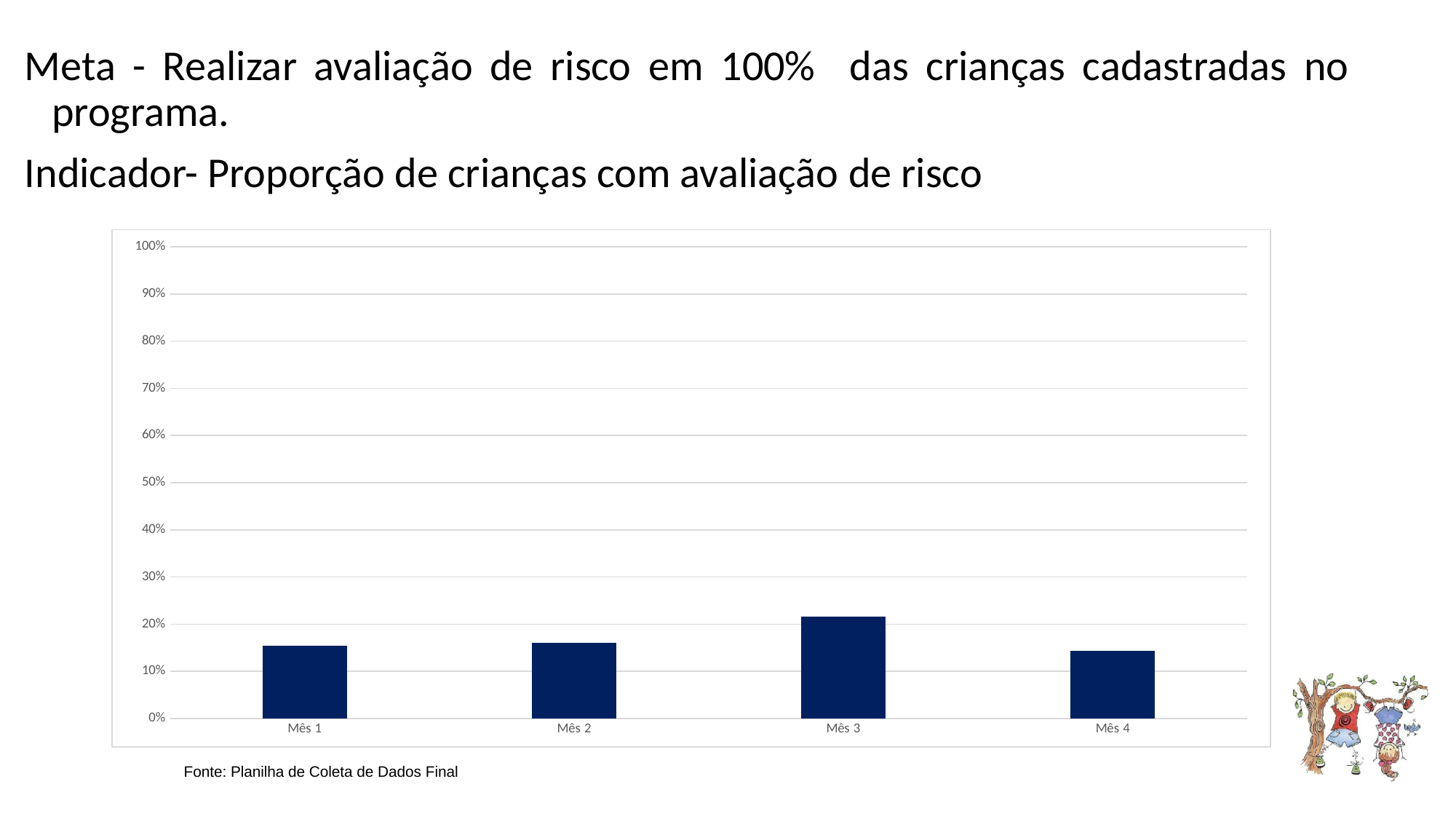
What source is cited below the chart? Planilha de Coleta de Dados Final How many categories (months) are shown on the x axis of the chart? 4 What kind of chart is shown on the slide? bar chart Is the value for Mês 3 greater or less than 20%? greater Is the value for Mês 2 greater or less than 30%? less Is the value for Mês 4 greater or less than 20%? less Which month has the highest proportion of children with risk assessment? Mês 3 Which is larger, the value for Mês 3 or the value for Mês 4? Mês 3 What is the maximum value shown on the chart's y axis? 100% Which is larger, the value for Mês 3 or the value for Mês 2? Mês 3